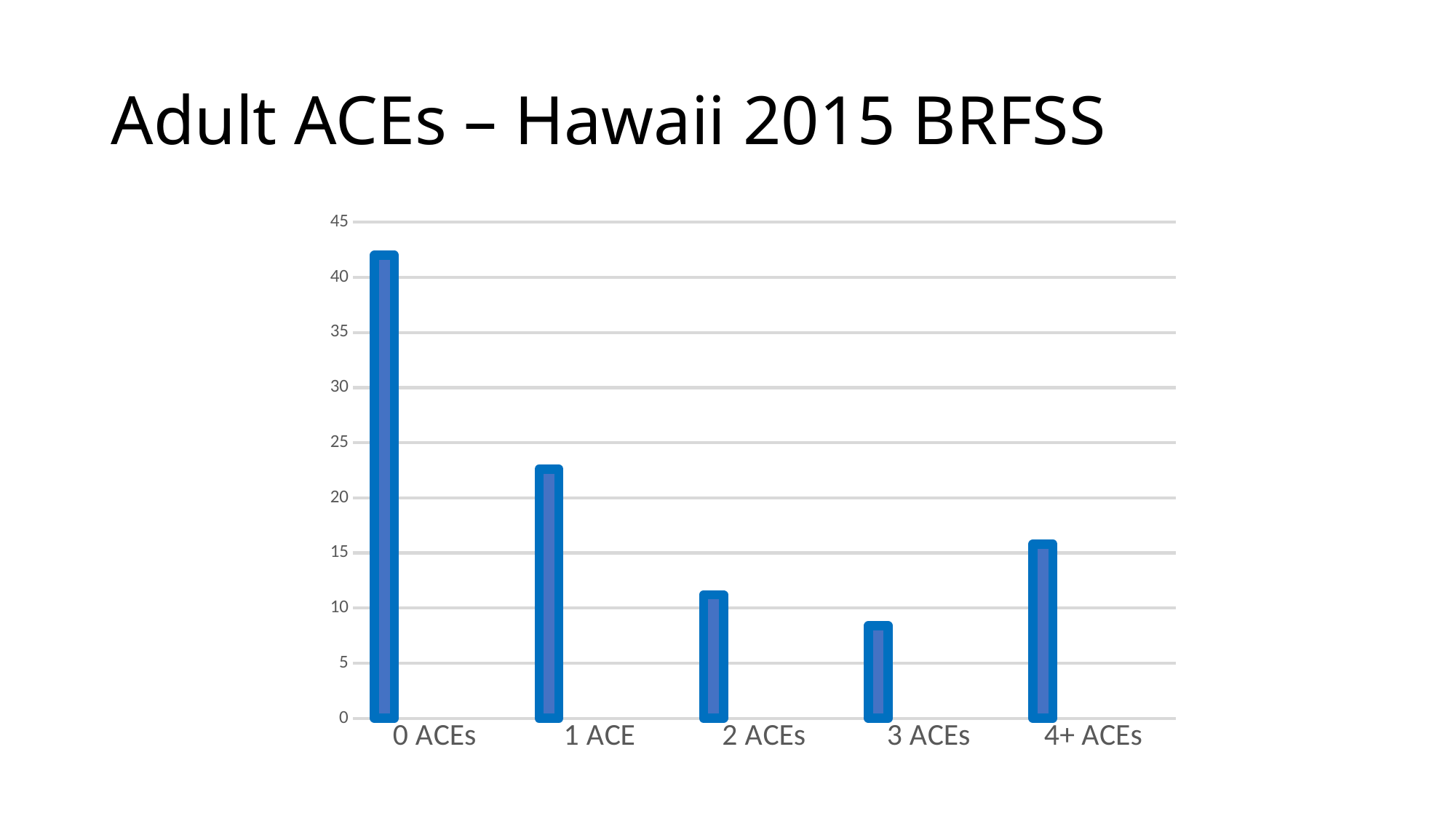
Is the value for 2 ACEs greater or less than 10? greater Which category has the highest bar? 0 ACEs Which is larger, the value for 1 ACE or the value for 4+ ACEs? 1 ACE Is the value for 1 ACE greater or less than 25? less What kind of chart is shown on the slide? bar chart Is the value for 3 ACEs greater or less than 10? less Which is larger, the value for 4+ ACEs or the value for 2 ACEs? 4+ ACEs Which category has the lowest bar? 3 ACEs How many categories are shown on the x axis of the chart? 5 What is the title of the slide? Adult ACEs – Hawaii 2015 BRFSS